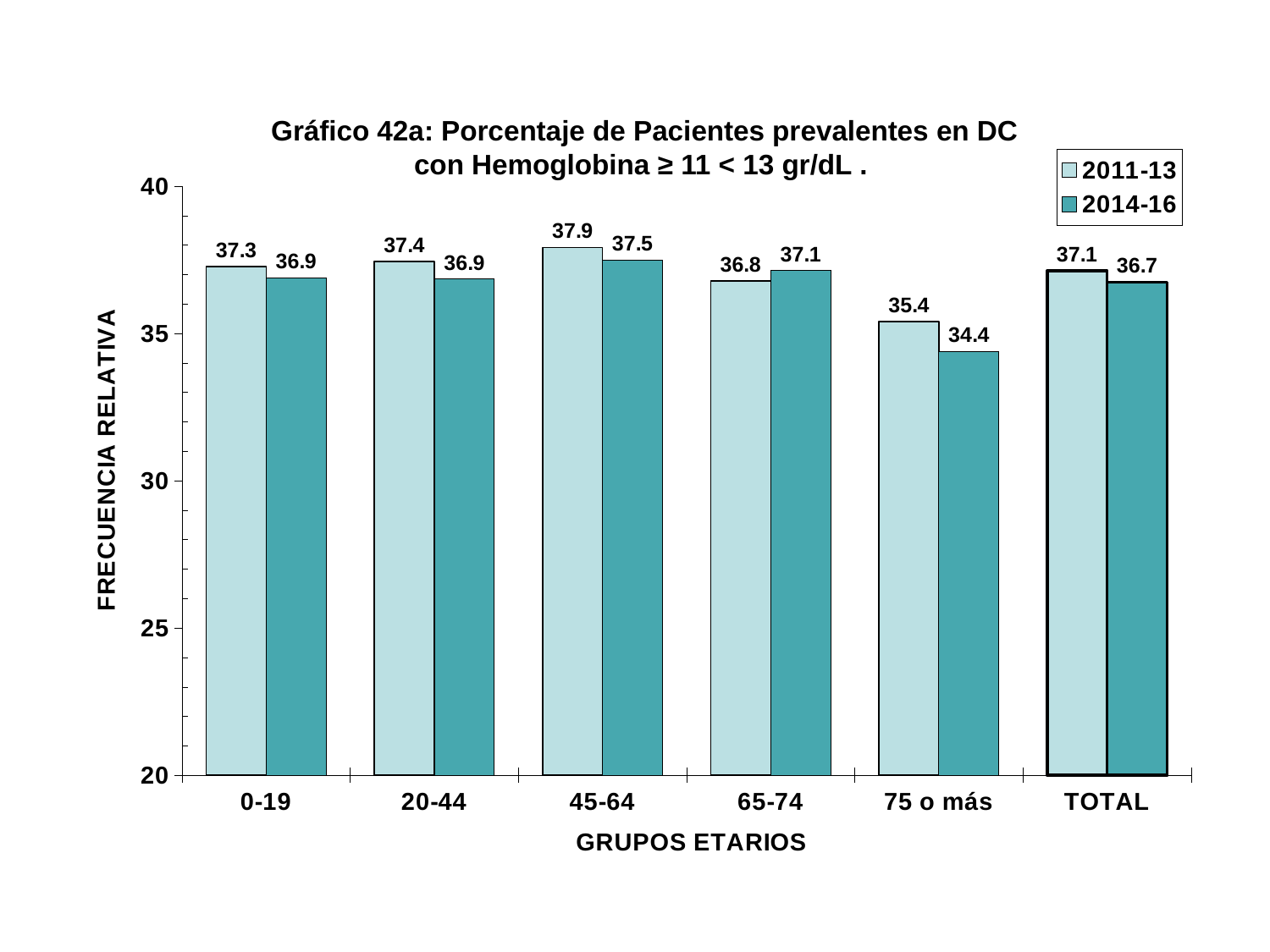
What is the value for the 75 o más age group in the 2014-16 series? 34.4 What kind of chart is shown on the slide? bar chart How many categories are shown on the x axis? 6 For the 65-74 age group, which series has the larger value, 2011-13 or 2014-16? 2014-16 What is the label of the y axis? FRECUENCIA RELATIVA What is the difference between the 2011-13 and 2014-16 values for the 75 o más age group? 1.0 Which age group has the highest value in the 2011-13 series? 45-64 Which age group has the lowest value in the 2014-16 series? 75 o más Is the 2014-16 value for the 75 o más age group greater or less than 35? less What is the TOTAL value for the 2014-16 series? 36.7 How many series does the legend list? 2 What is the value for the 45-64 age group in the 2011-13 series? 37.9